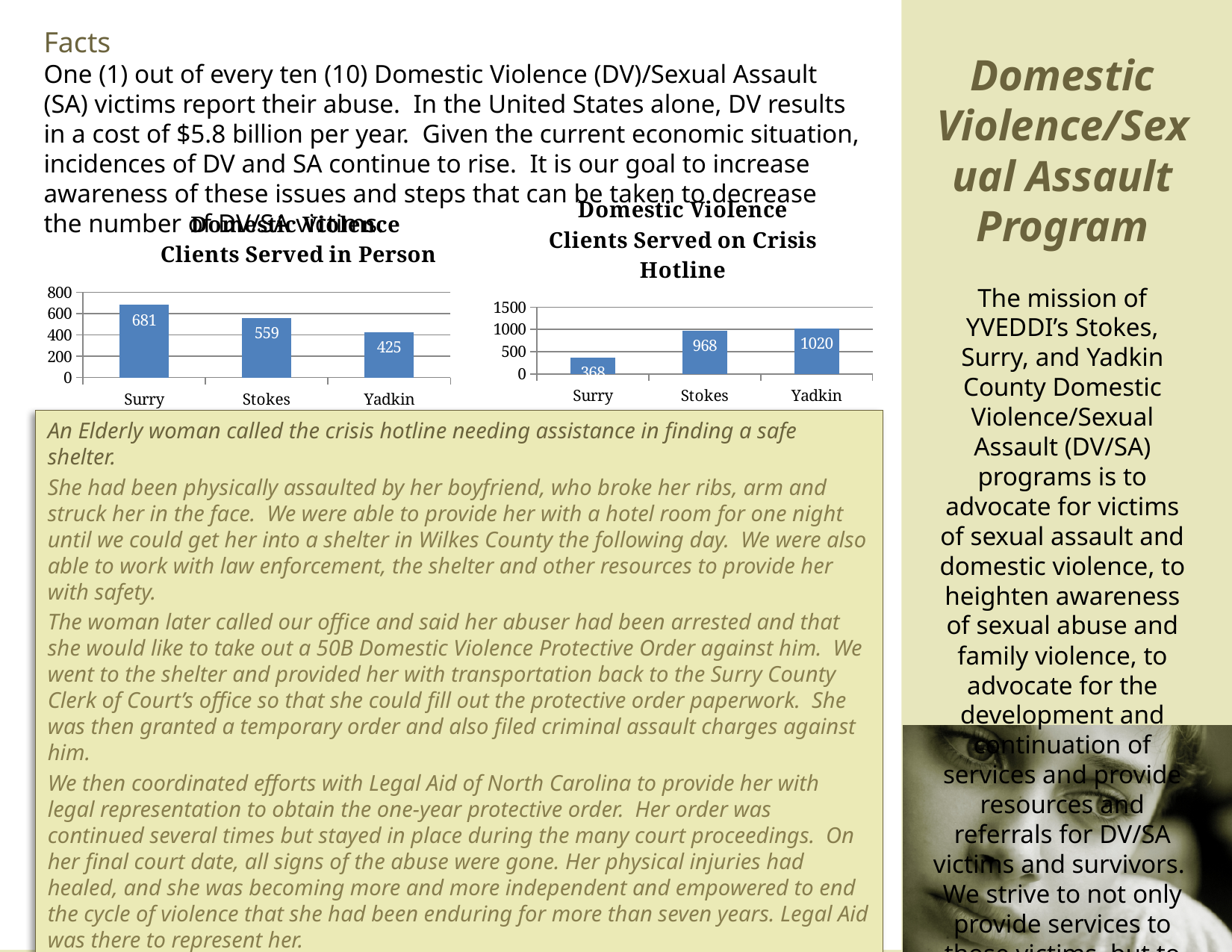
In the 'Domestic Violence Clients Served in Person' chart, which county has the lowest value? Yadkin In the 'Domestic Violence Clients Served in Person' chart, what is the difference between Surry and Stokes? 122 In the 'Domestic Violence Clients Served in Person' chart, what is the value for Yadkin? 425 In the 'Domestic Violence Clients Served in Person' chart, which county has the highest value? Surry What type of chart is the 'Domestic Violence Clients Served in Person' chart? bar chart In the 'Domestic Violence Clients Served on Crisis Hotline' chart, what is the value for Yadkin? 1020 In the 'Domestic Violence Clients Served on Crisis Hotline' chart, what is the difference between Yadkin and Stokes? 52 In the 'Domestic Violence Clients Served in Person' chart, how many clients were served in Surry? 681 In the 'Domestic Violence Clients Served on Crisis Hotline' chart, which county has the lowest value? Surry In the 'Domestic Violence Clients Served in Person' chart, do the values rise or fall from Surry to Yadkin? fall In the 'Domestic Violence Clients Served on Crisis Hotline' chart, what is the value for Stokes? 968 In the 'Domestic Violence Clients Served on Crisis Hotline' chart, is the value for Surry greater or less than 500? less